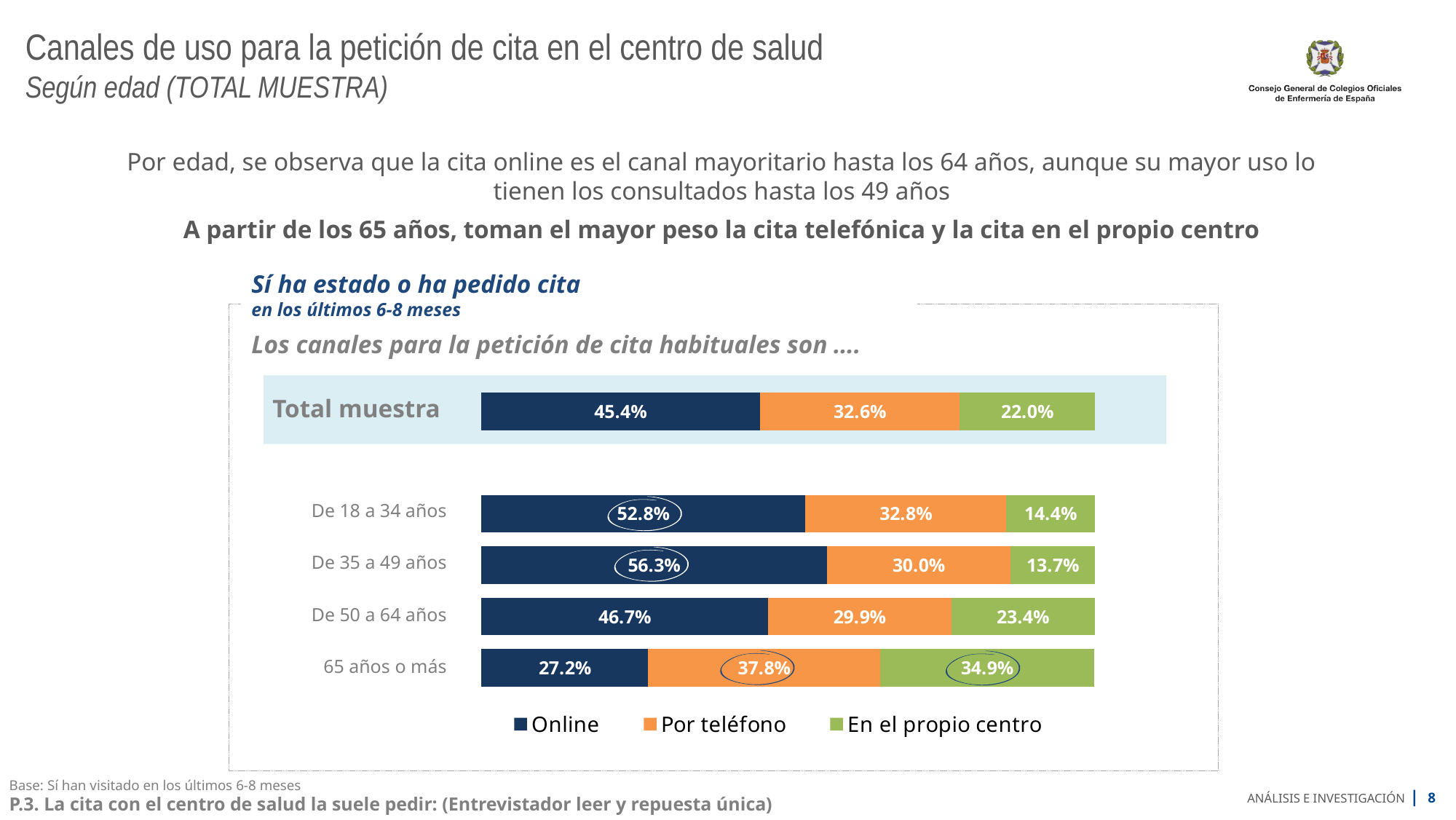
What is the 'En el propio centro' value for 'Total muestra'? 22.0% How many series does the legend list? 3 What is the difference between the Online values for 'De 18 a 34 años' and '65 años o más'? 25.6% Which age group has the lowest 'En el propio centro' value? De 35 a 49 años What is the 'Por teléfono' value for the '65 años o más' age group? 37.8% Which is larger for the 'De 50 a 64 años' group: the Online value or the 'Por teléfono' value? Online Which age group has the highest Online value? De 35 a 49 años How many age groups are shown below the 'Total muestra' bar? 4 What is the Online value for the 'De 35 a 49 años' age group? 56.3% What is the total of the stacked bar for 'De 18 a 34 años'? 100.0% What kind of chart is shown on the slide? Stacked bar chart Which colour represents 'Por teléfono' in the chart? Orange